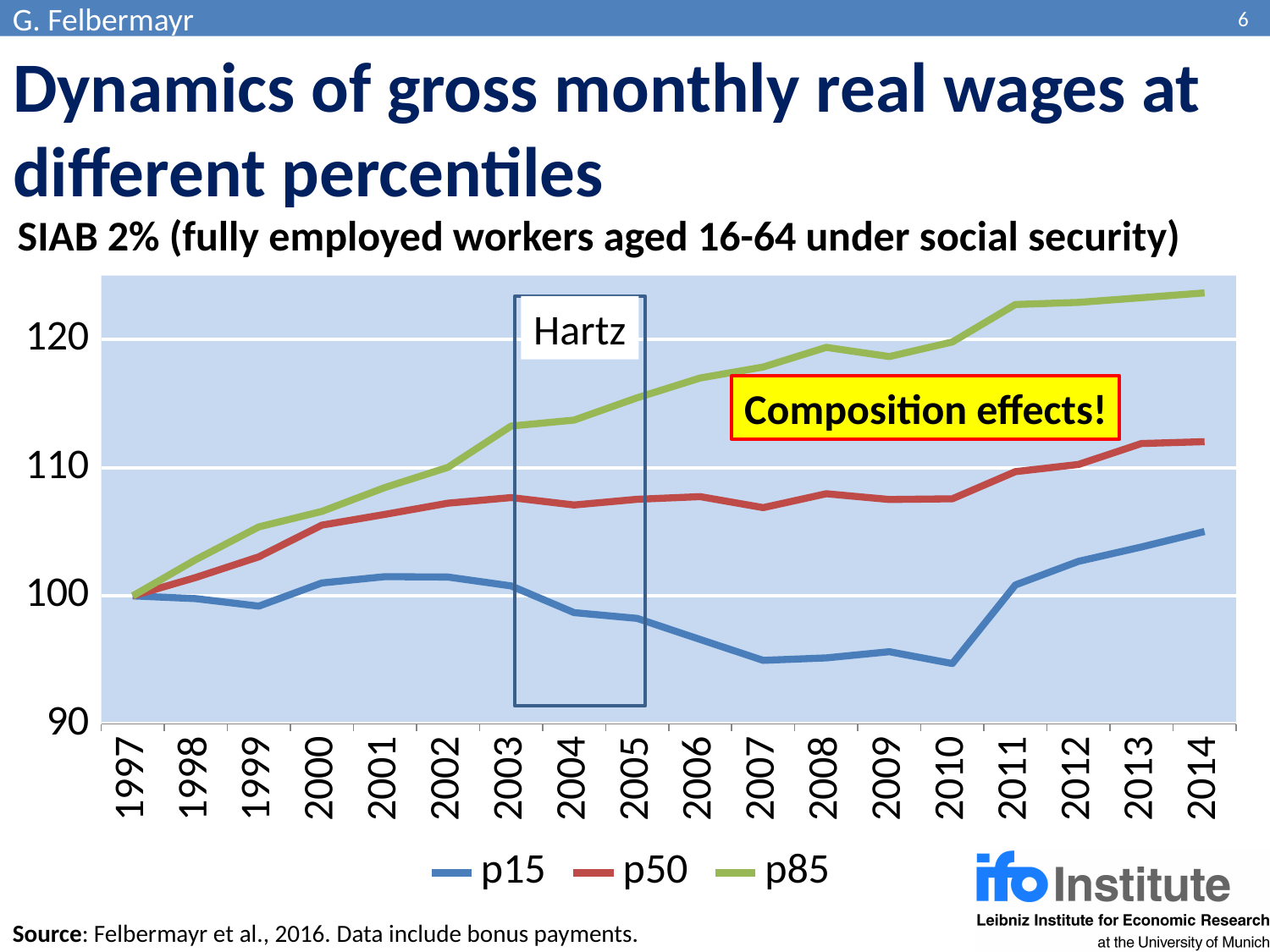
Is the value for p50 in 2014 greater or less than 110? greater Is the value for p85 in 2003 greater or less than 110? greater How many series does the legend list? 3 Does the p85 series generally rise or fall from 1997 to 2014? rise Which series has the lowest value in 2010? p15 Is the value for p15 in 2010 greater or less than 100? less What kind of chart is shown on the slide? line chart How many years are shown on the x axis? 18 Which is larger in 2008, the value for p50 or the value for p15? p50 Which series has the highest value in 2014? p85 What label is written inside the box drawn over the years 2003 to 2005? Hartz